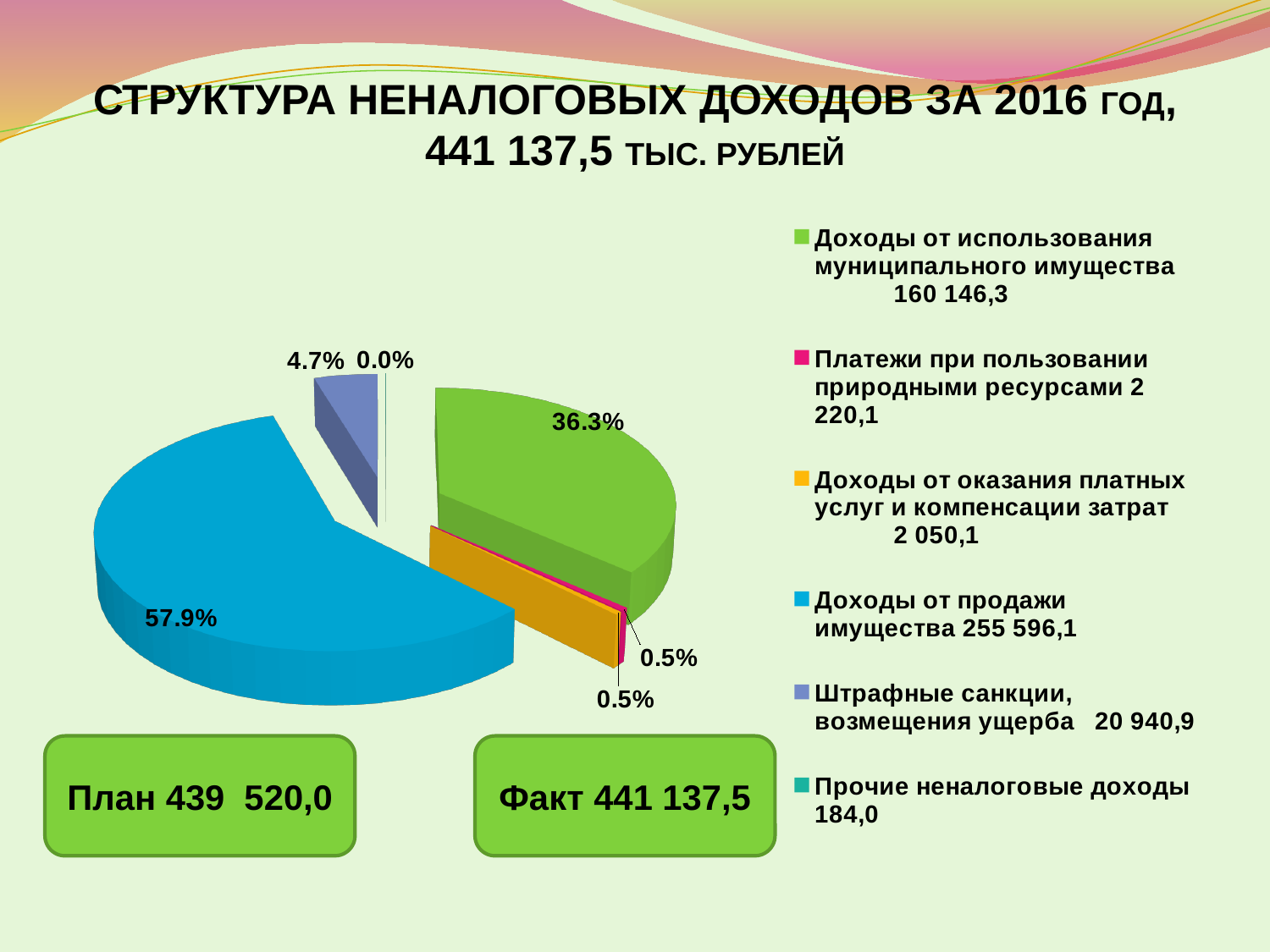
What kind of chart is shown on the slide? Pie chart What share of the pie does "Прочие неналоговые доходы" take? 0.0% What share of the pie does "Доходы от продажи имущества" take? 57.9% What value is shown in the legend for "Доходы от продажи имущества"? 255 596,1 What is the difference in percentage points between the "Доходы от продажи имущества" slice and the "Доходы от использования муниципального имущества" slice? 21.6 Which slice is larger: "Штрафные санкции, возмещения ущерба" or "Доходы от оказания платных услуг и компенсации затрат"? Штрафные санкции, возмещения ущерба What colour is the slice for "Доходы от использования муниципального имущества"? Green What share of the pie does "Доходы от использования муниципального имущества" take? 36.3% How many entries does the legend list? 6 Which category has the smallest slice of the pie? Прочие неналоговые доходы Which category has the largest slice of the pie? Доходы от продажи имущества